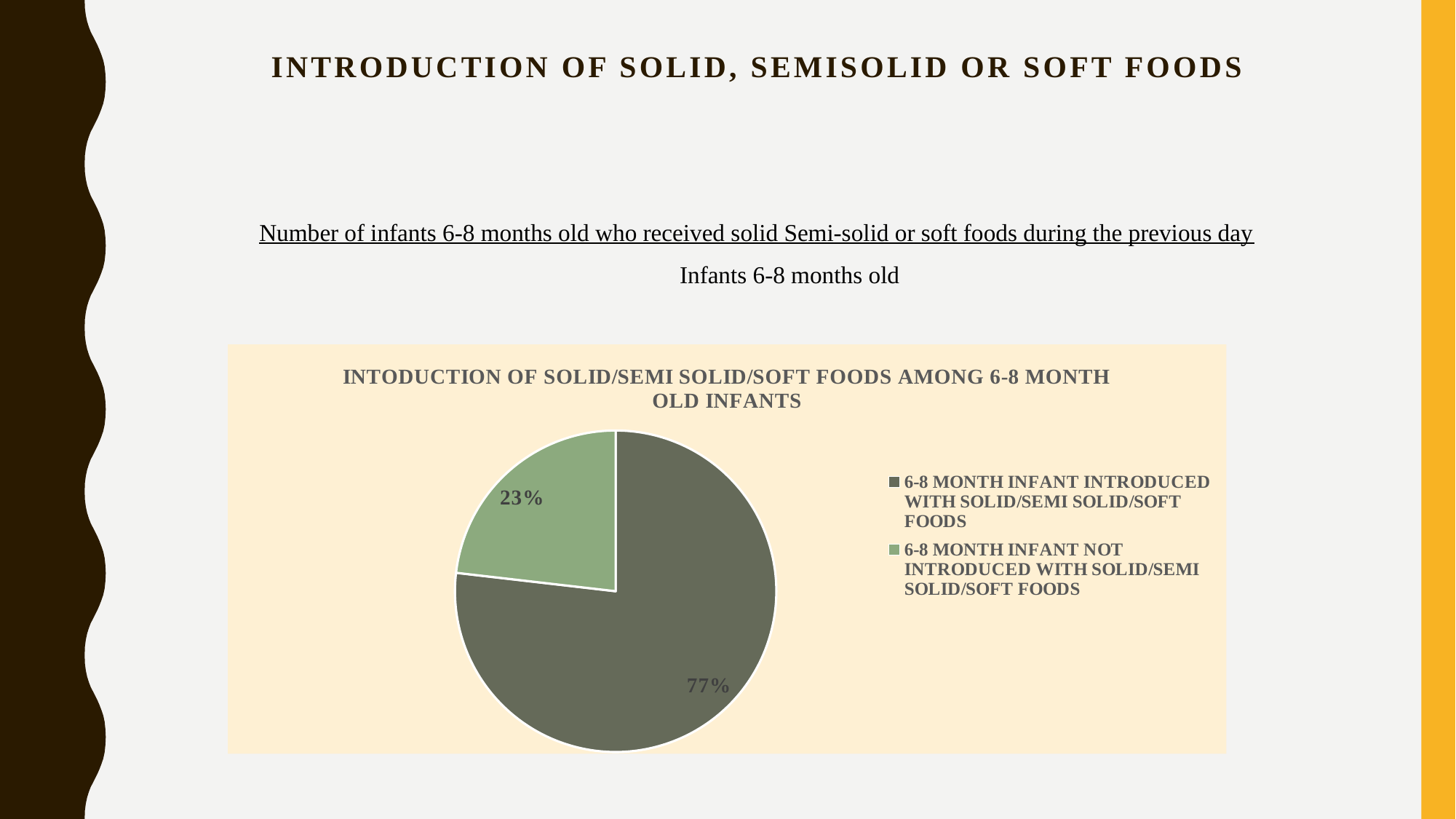
What share of the pie is for 6-8 month infants introduced with solid/semi solid/soft foods? 77% What share of the pie is for 6-8 month infants not introduced with solid/semi solid/soft foods? 23% What is the difference in percentage points between the introduced and not introduced slices? 54 Which category has the smallest slice of the pie? 6-8 month infant not introduced with solid/semi solid/soft foods Which is larger: the slice for infants introduced with solid/semi solid/soft foods or the slice for infants not introduced? Infants introduced with solid/semi solid/soft foods Which category has the largest slice of the pie? 6-8 month infant introduced with solid/semi solid/soft foods How many entries does the legend list? 2 Which slice is shown in the lighter green colour? 6-8 month infant not introduced with solid/semi solid/soft foods What kind of chart is shown on the slide? Pie chart How many slices does the pie chart have? 2 What is the title of the chart? INTODUCTION OF SOLID/SEMI SOLID/SOFT FOODS AMONG 6-8 MONTH OLD INFANTS